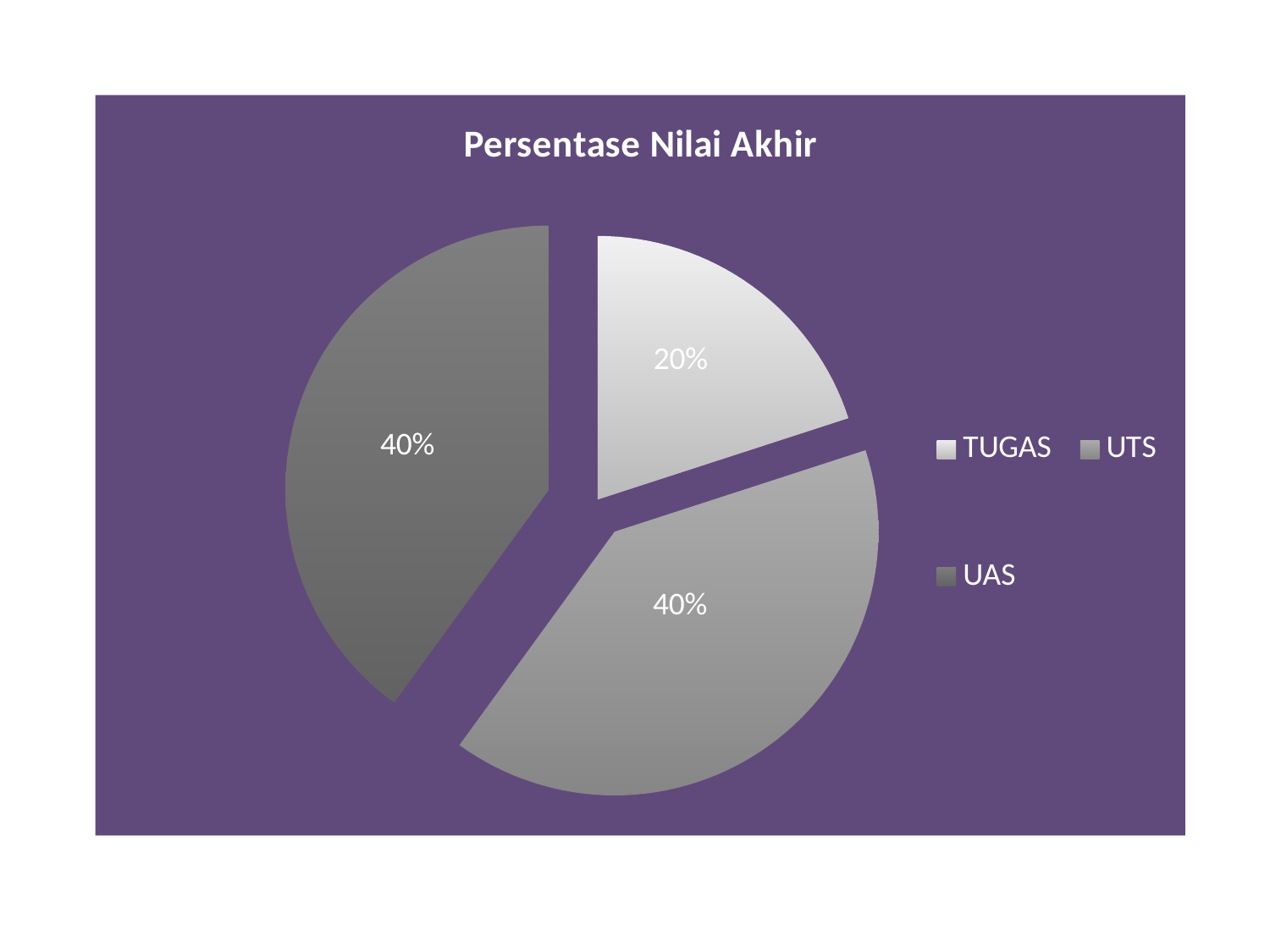
What is the combined share of UTS and UAS in the pie chart? 80% Which category has the smallest share of the pie chart? TUGAS How many categories are shown in the pie chart? 3 What percentage does the TUGAS slice represent in the pie chart? 20% Which categories are listed in the chart legend? TUGAS, UTS, UAS Do the UTS and UAS slices have the same share of the pie? Yes What percentage does the UTS slice represent in the pie chart? 40% What kind of chart is shown on the slide? Pie chart What is the title of the chart? Persentase Nilai Akhir What is the difference between the UAS share and the TUGAS share? 20% What percentage does the UAS slice represent in the pie chart? 40% Which is larger, the share for TUGAS or the share for UTS? UTS